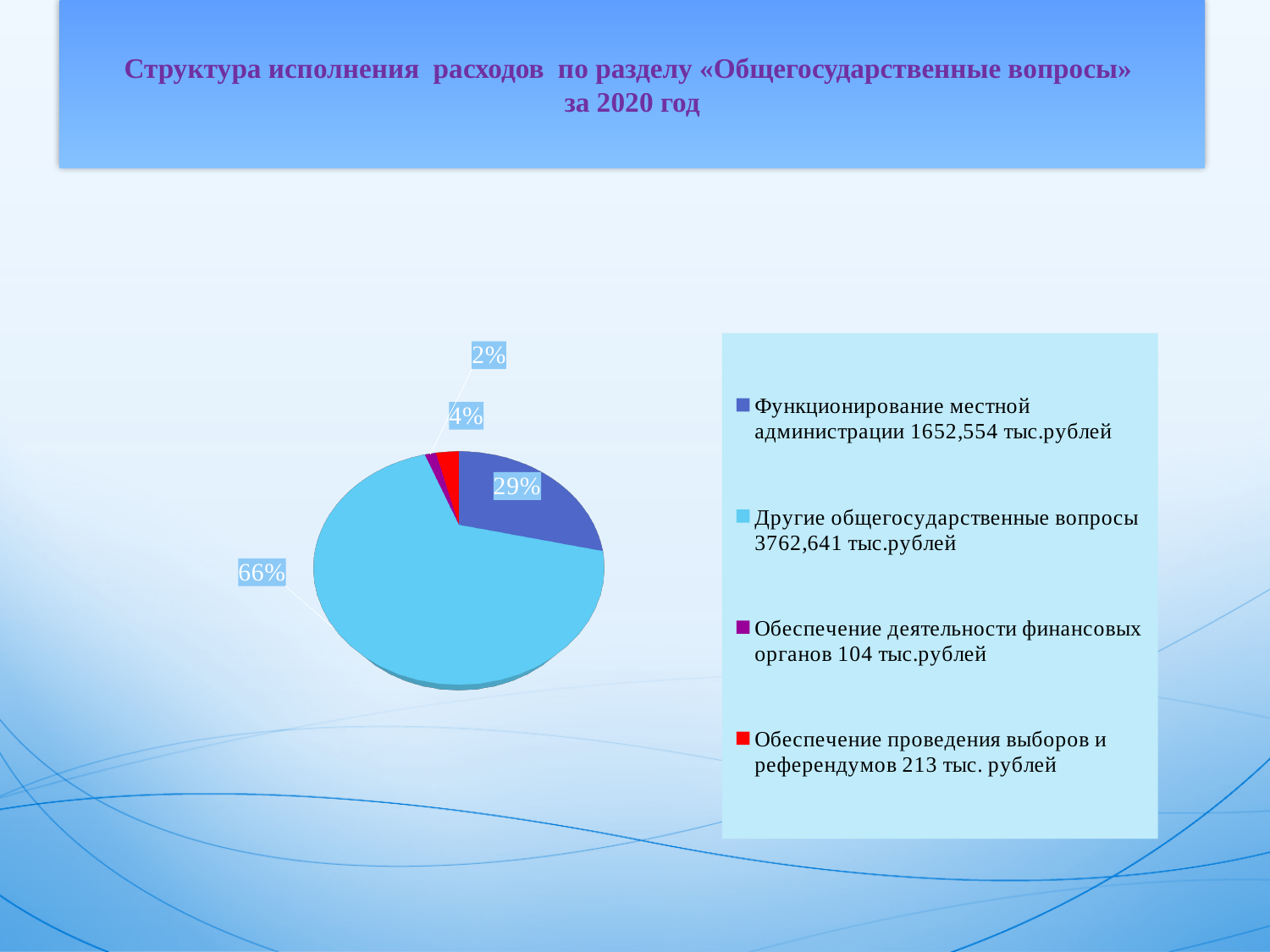
What is the title of the slide containing the chart? Структура исполнения расходов по разделу «Общегосударственные вопросы» за 2020 год What amount is given in the legend for «Обеспечение проведения выборов и референдумов»? 213 тыс. рублей What amount is given in the legend for «Функционирование местной администрации»? 1652,554 тыс.рублей What is the difference in percentage points between the 66% slice and the 29% slice? 37 What share of the pie does «Другие общегосударственные вопросы» take? 66% What kind of chart is shown on the slide? pie chart Which category has the largest share of the pie? Другие общегосударственные вопросы Which category has the smallest share of the pie? Обеспечение деятельности финансовых органов How many slices does the pie chart have? 4 What amount is given in the legend for «Обеспечение деятельности финансовых органов»? 104 тыс.рублей Which is larger: the share for «Другие общегосударственные вопросы» or for «Функционирование местной администрации»? Другие общегосударственные вопросы What share of the pie does «Функционирование местной администрации» take? 29%